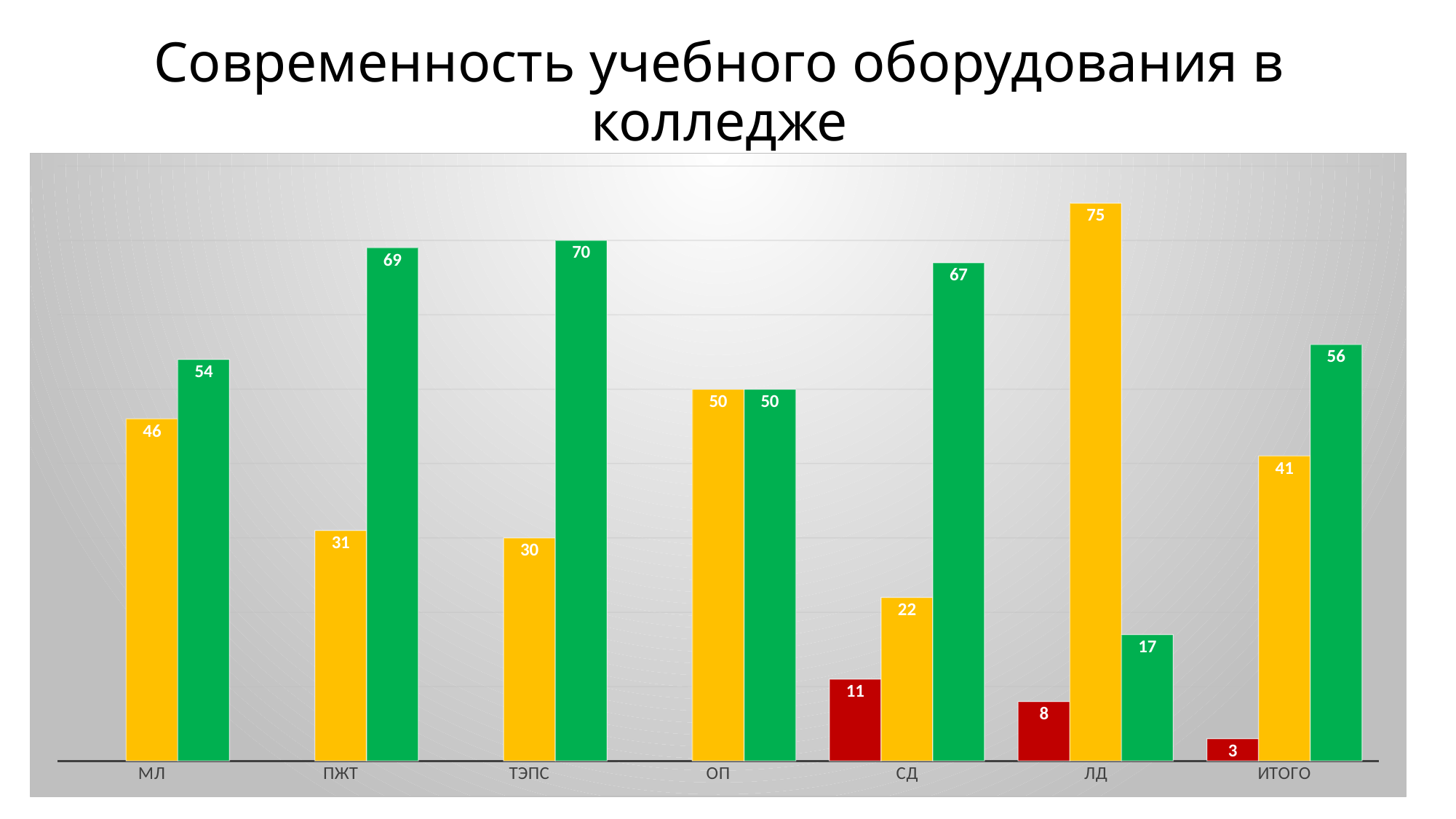
How many categories have a red bar? 3 Which is larger for ЛД, the yellow bar or the green bar? the yellow bar What is the value of the green bar for ПЖТ? 69 Which category has the lowest red bar? ИТОГО What kind of chart is shown on the slide? bar chart How many categories are shown on the x axis? 7 What is the difference between the green and yellow bars for ПЖТ? 38 Which category has the highest green bar? ТЭПС What is the title of the chart? Современность учебного оборудования в колледже What is the value of the yellow bar for ЛД? 75 What is the value of the red bar for СД? 11 What is the value of the yellow bar for ИТОГО? 41